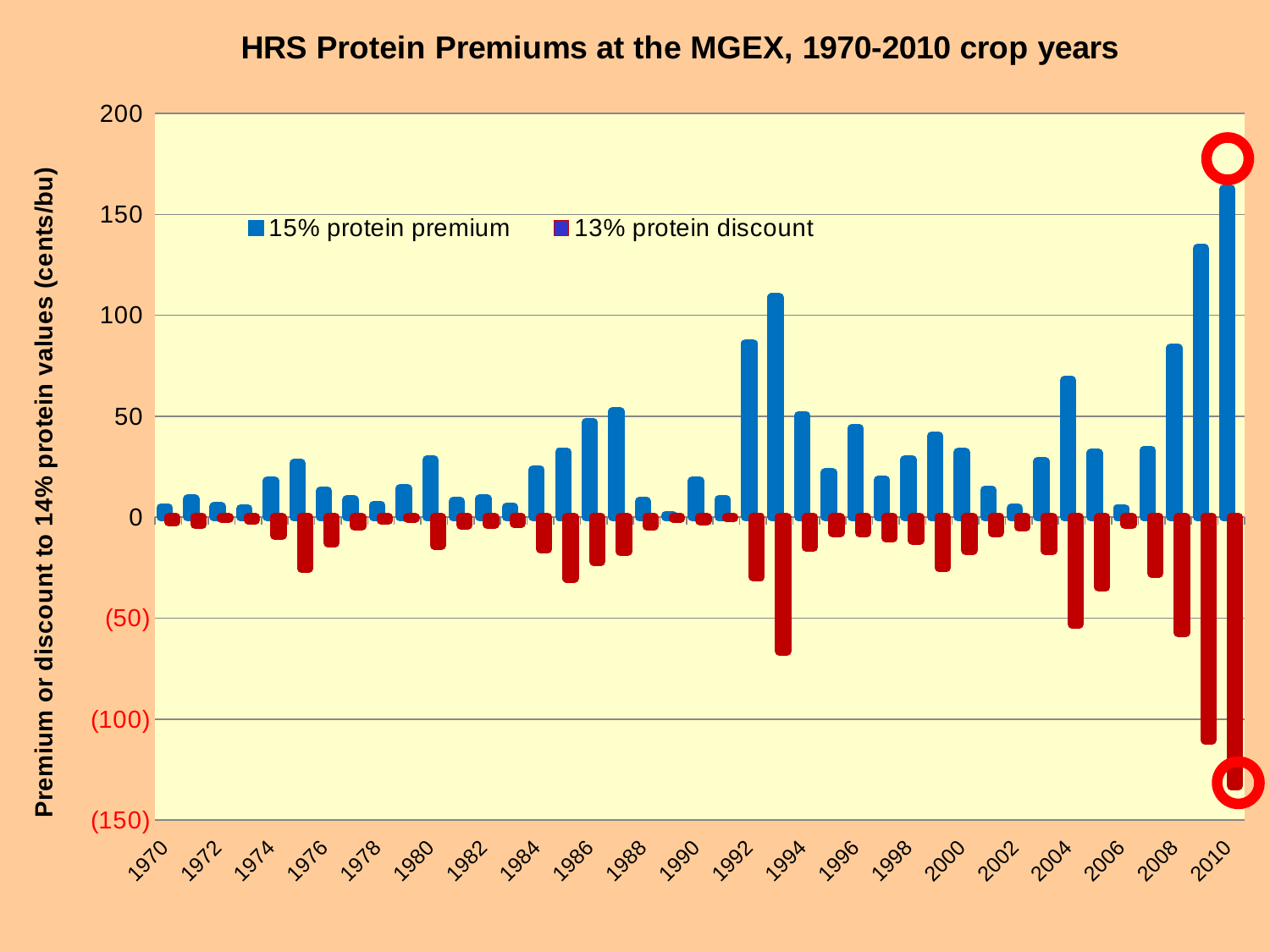
Which colour represents the 13% protein discount series? red What is the title of the chart? HRS Protein Premiums at the MGEX, 1970-2010 crop years In which crop year is the 15% protein premium highest? 2010 Is the 15% protein premium for 2010 greater or less than 150? greater How many series does the legend list? 2 Is the 15% protein premium for 1993 greater or less than 100? greater What kind of chart is shown on the slide? bar chart Which year has the larger 15% protein premium, 2004 or 2005? 2004 Which year has the larger 15% protein premium, 1992 or 1993? 1993 Is the 13% protein discount for 1993 greater or less than (50)? less In which crop year is the 13% protein discount the most negative (lowest)? 2010